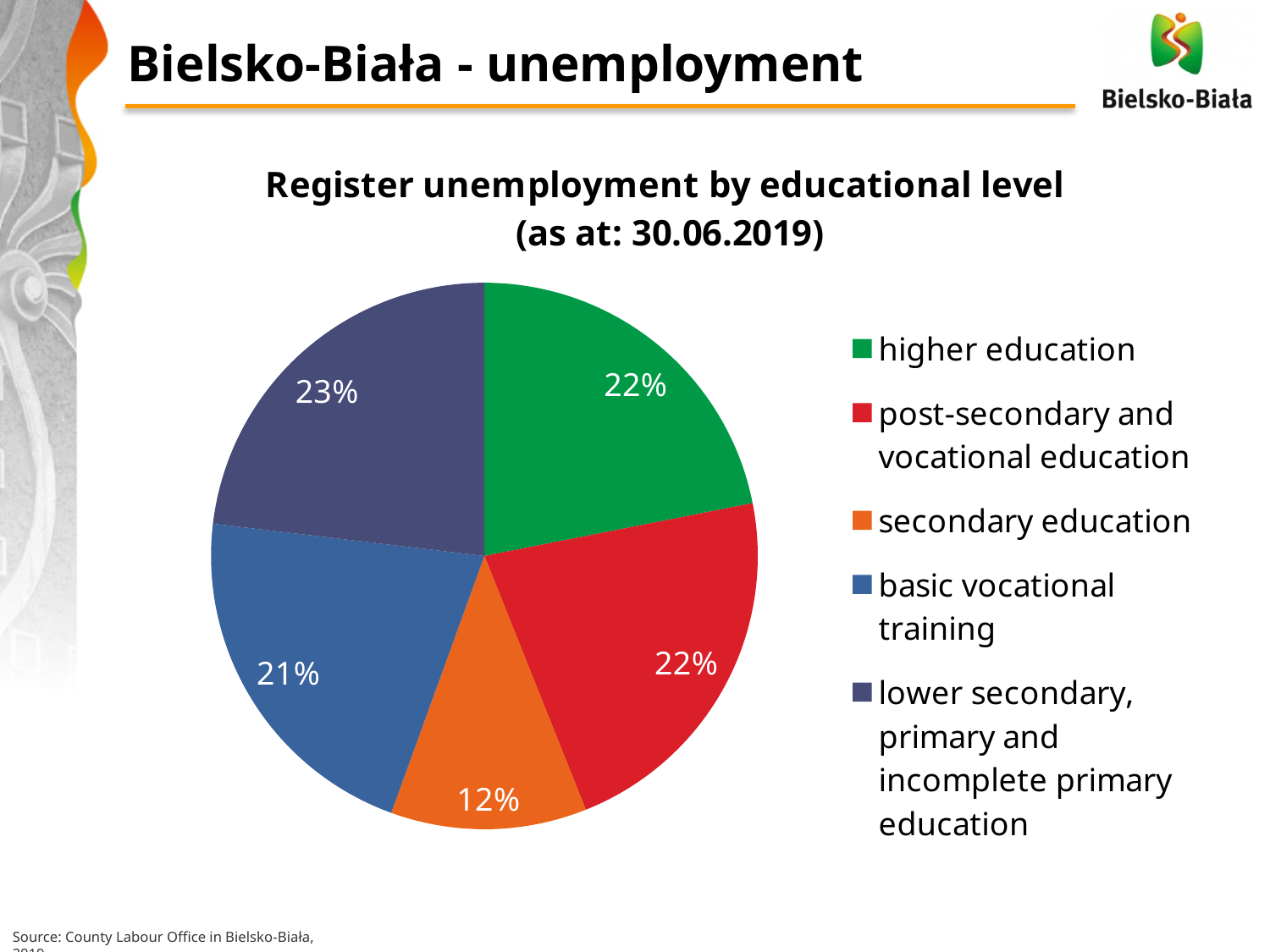
What kind of chart is shown on the slide? pie chart What share of registered unemployment is attributed to post-secondary and vocational education? 22% What share of registered unemployment is attributed to higher education? 22% What share of registered unemployment is attributed to basic vocational training? 21% What share of registered unemployment is attributed to secondary education? 12% How many educational level categories does the pie chart show? 5 Which colour represents secondary education in the pie chart? orange What is the title of the chart? Register unemployment by educational level (as at: 30.06.2019) Which educational level has the largest share of registered unemployment? lower secondary, primary and incomplete primary education Which educational level has the smallest share of registered unemployment? secondary education What share of registered unemployment is attributed to lower secondary, primary and incomplete primary education? 23% What is the difference in percentage points between the share for basic vocational training and the share for secondary education? 9 percentage points